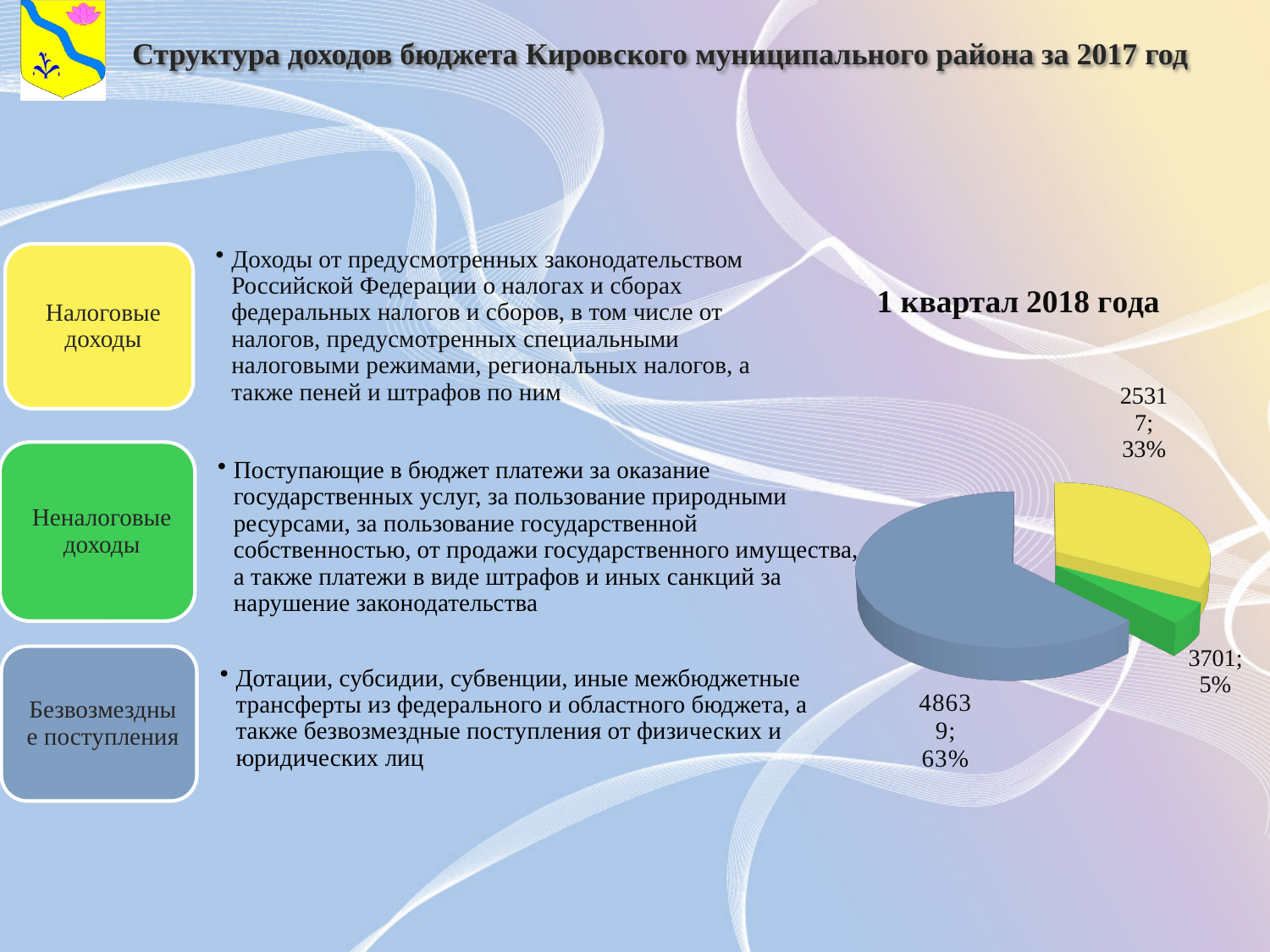
What value is labelled on the green slice of the pie chart? 3701 What value is labelled on the yellow slice of the pie chart? 25317 Which slice of the pie chart is the largest? The blue slice (63%) What type of chart is shown on the slide? Pie chart What value is labelled on the blue slice of the pie chart? 48639 Which slice of the pie chart is the smallest? The green slice (5%) What percentage share does the green slice of the pie chart have? 5% What is the difference between the value of the blue slice and the value of the yellow slice in the pie chart? 23322 What is the title of the pie chart? 1 квартал 2018 года What percentage share does the blue slice of the pie chart have? 63% What percentage share does the yellow slice of the pie chart have? 33% How many slices does the pie chart have? 3